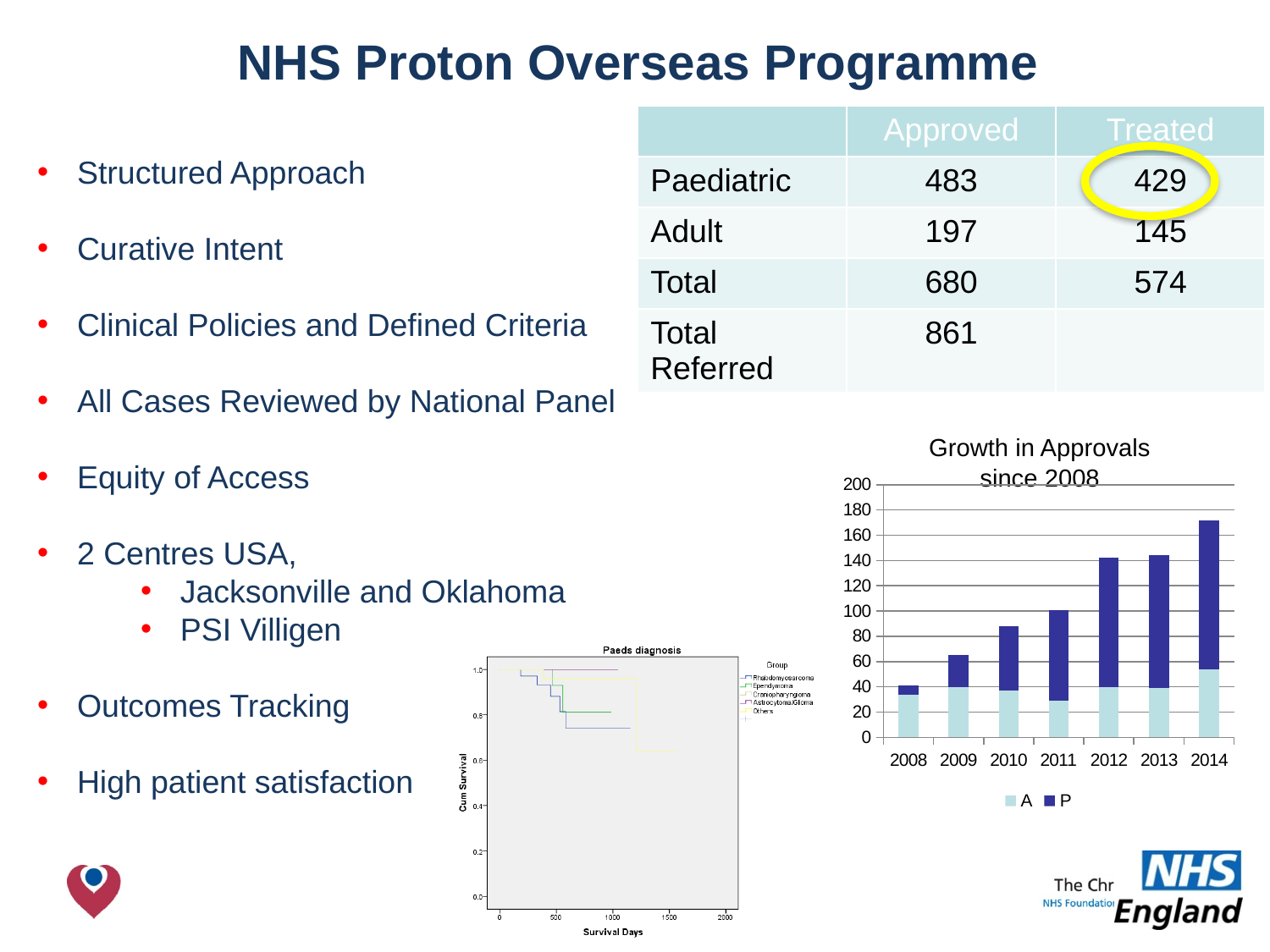
In the 'Growth in Approvals since 2008' chart, which year has the highest total bar? 2014 In the 'Growth in Approvals since 2008' chart, is the total bar for 2012 greater or less than 120? greater In the 'Growth in Approvals since 2008' chart, is the total bar for 2008 greater or less than 60? less In the 'Growth in Approvals since 2008' chart, is the total bar for 2014 greater or less than 160? greater In the 'Growth in Approvals since 2008' chart, how many series does the legend list? 2 In the 'Growth in Approvals since 2008' chart, do the total bars generally rise or fall from 2008 to 2014? rise What kind of chart is the 'Growth in Approvals since 2008' chart? stacked bar chart In the 'Growth in Approvals since 2008' chart, which year has the lowest total bar? 2008 In the 'Growth in Approvals since 2008' chart, how many years are shown on the x axis? 7 In the 'Growth in Approvals since 2008' chart, what are the two legend entries? A and P In the 'Growth in Approvals since 2008' chart, which total bar is larger, 2011 or 2014? 2014